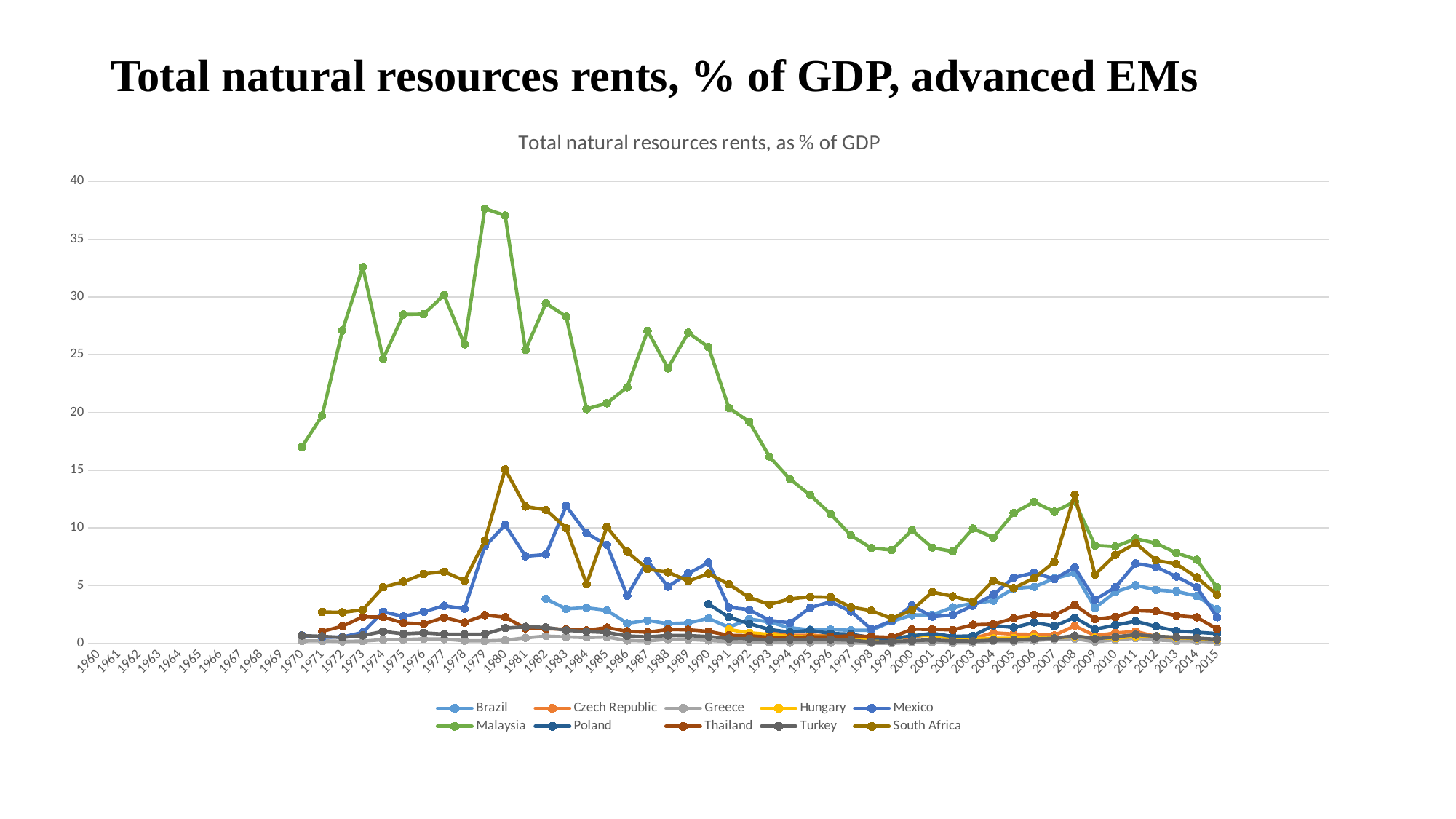
Is the value for South Africa in 1980 greater or less than 10? greater Is the value for Malaysia in 1979 greater or less than 35? greater Is the value for Malaysia in 1970 greater or less than 15? greater What is the highest value shown on the vertical axis? 40 Which country's series reaches the highest value on the chart? Malaysia How many series does the legend list? 10 What is the title printed inside the chart area? Total natural resources rents, as % of GDP Does the Malaysia series rise or fall between 1990 and 1998? fall What kind of chart is shown on the slide? line chart In 1980, which is higher, South Africa or Mexico? South Africa